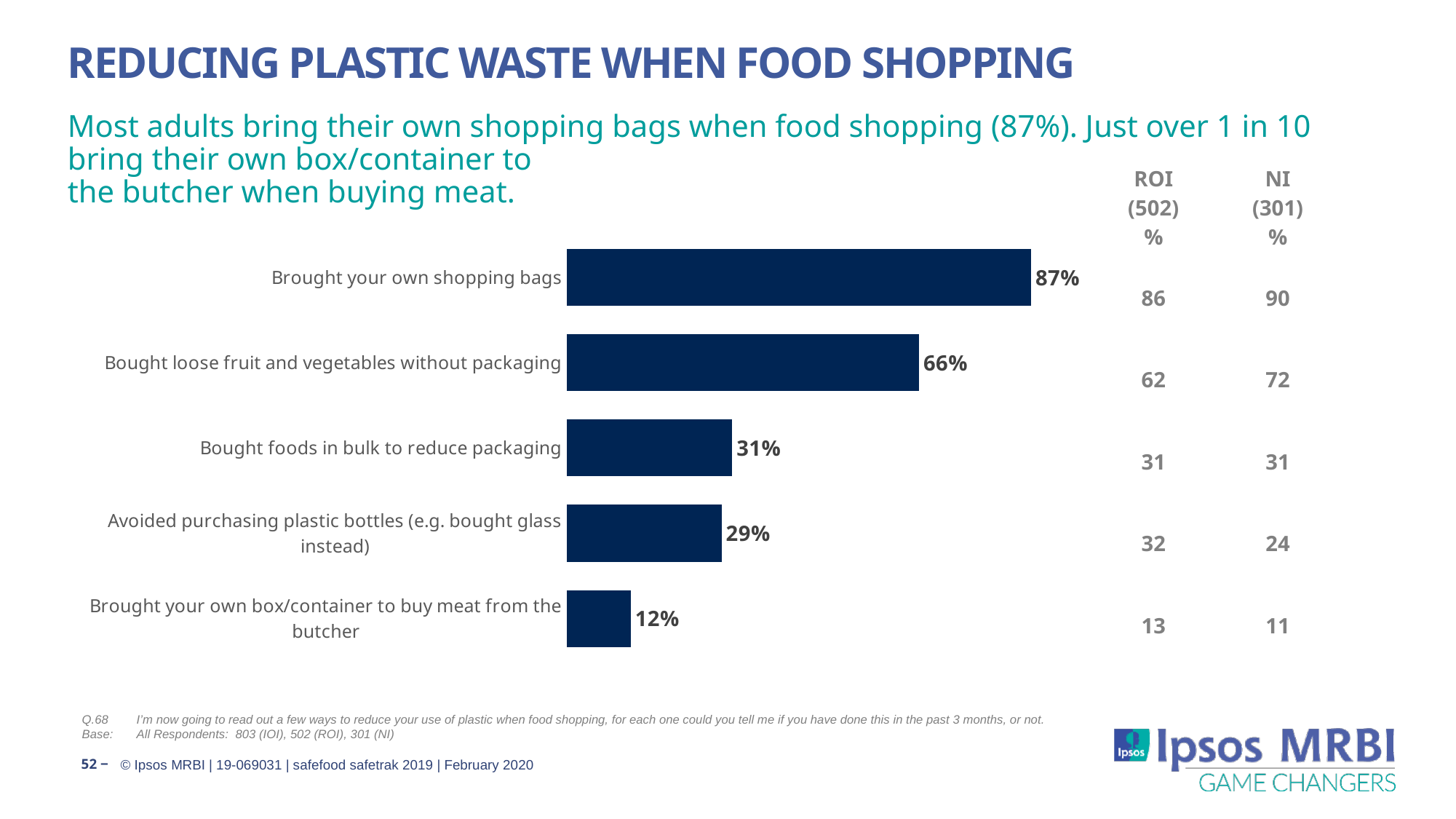
What is the difference between the values for 'Avoided purchasing plastic bottles (e.g. bought glass instead)' and 'Brought your own box/container to buy meat from the butcher'? 17% Which category has the highest value in the chart? Brought your own shopping bags What is the value for 'Bought foods in bulk to reduce packaging'? 31% What percentage of adults brought their own shopping bags when food shopping? 87% What is the title of the slide containing the chart? REDUCING PLASTIC WASTE WHEN FOOD SHOPPING How many categories are shown in the bar chart? 5 What type of chart is shown on the slide? Bar chart Which category has the lowest value in the chart? Brought your own box/container to buy meat from the butcher What percentage bought loose fruit and vegetables without packaging? 66% What is the difference between the values for 'Brought your own shopping bags' and 'Bought loose fruit and vegetables without packaging'? 21% What percentage avoided purchasing plastic bottles (e.g. bought glass instead)? 29% Which is larger: the value for 'Bought foods in bulk to reduce packaging' or 'Avoided purchasing plastic bottles (e.g. bought glass instead)'? Bought foods in bulk to reduce packaging